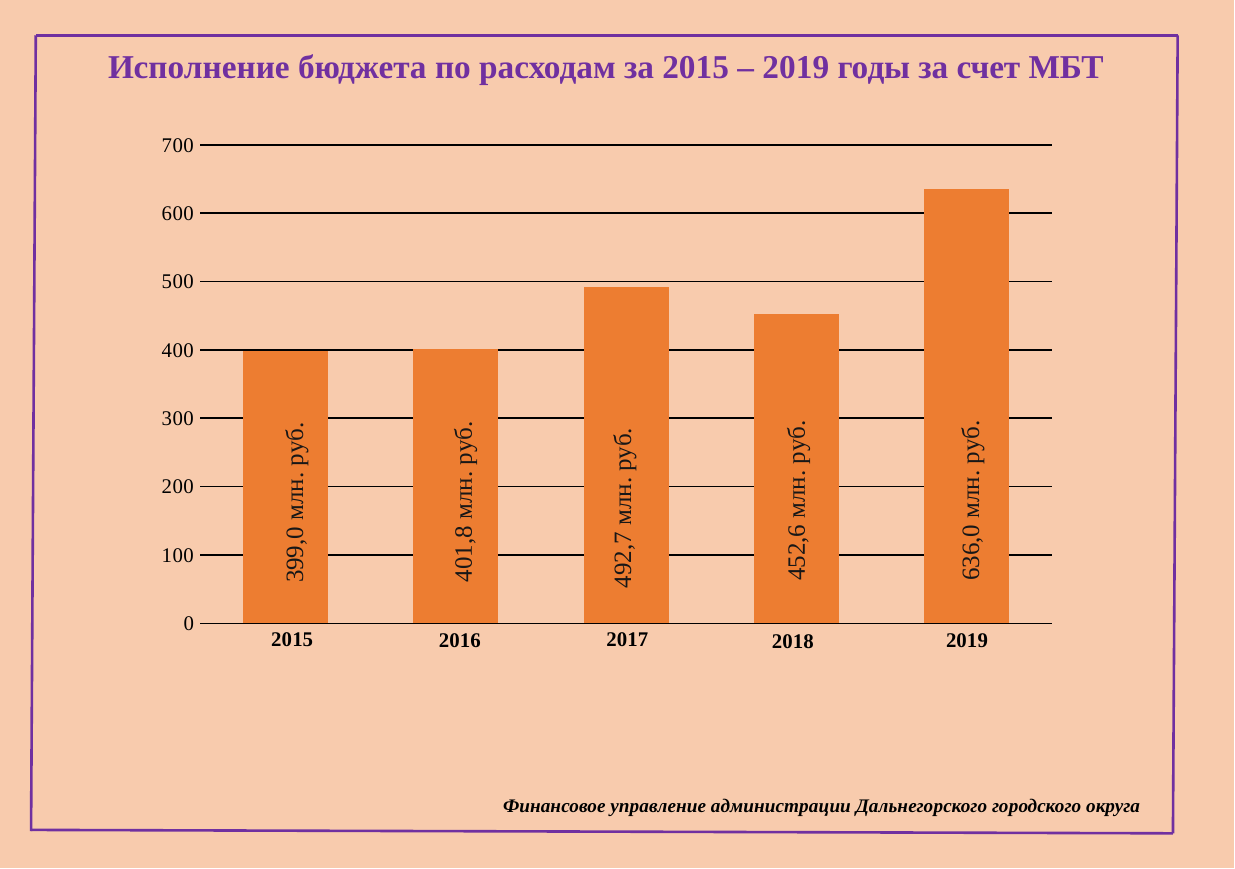
What is the value for 2015? 399,0 млн. руб. Which year has the highest value? 2019 What is the value for 2017? 492,7 млн. руб. What is the value for 2019? 636,0 млн. руб. What kind of chart is shown on the slide? bar chart Does the value rise or fall from 2017 to 2018? fall Which year has the lowest value? 2015 Which is larger, the value for 2017 or the value for 2018? 2017 What is the difference between the values for 2017 and 2018? 40,1 млн. руб. What is the difference between the values for 2019 and 2015? 237,0 млн. руб. Is the value for 2019 greater or less than 600? greater How many years are shown on the x axis? 5